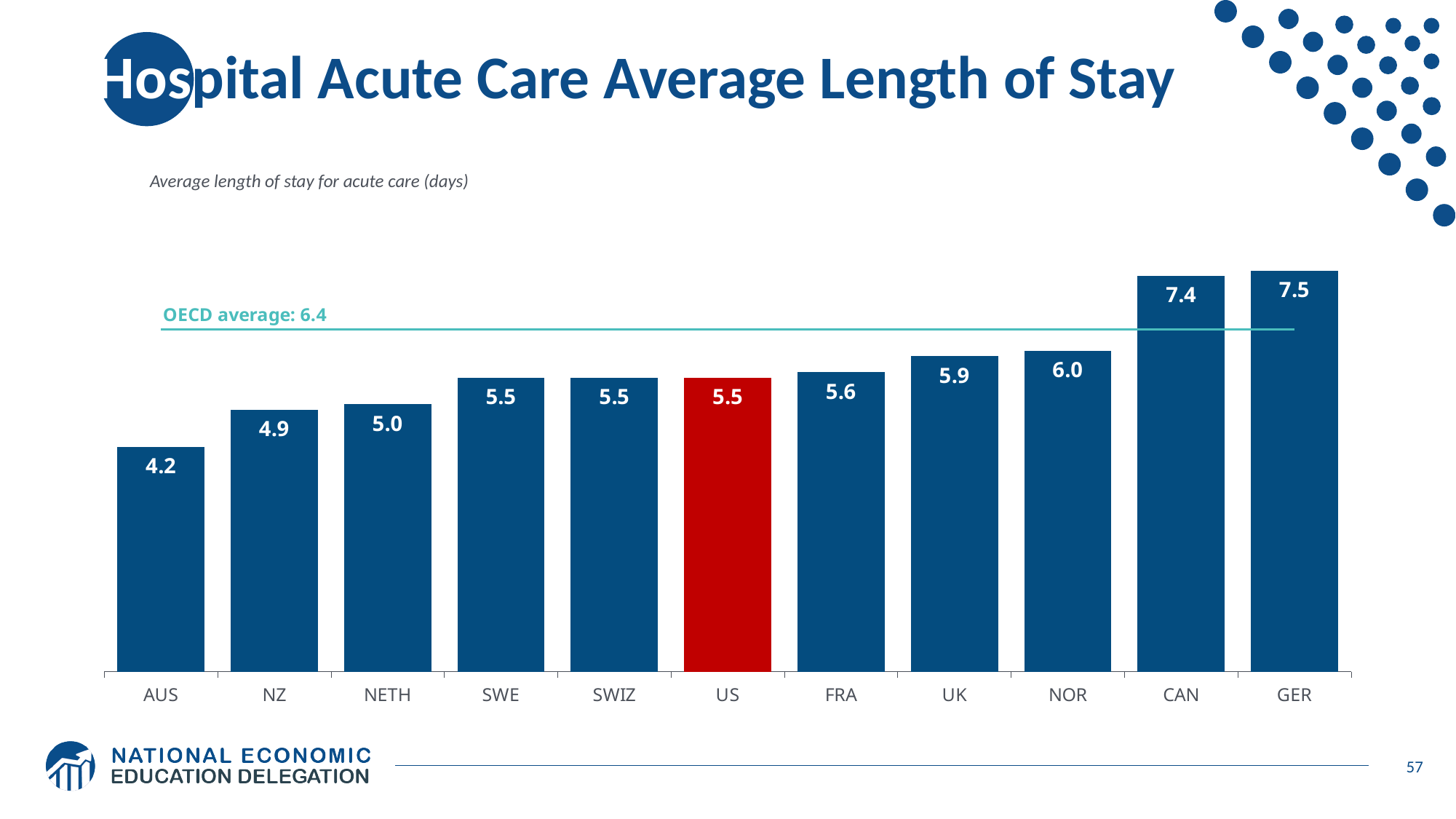
What is the average length of stay for acute care in the US? 5.5 What is the difference between the values for CAN and US? 1.9 What is the difference between the values for GER and AUS? 3.3 How many countries are shown on the chart? 11 Which has a longer average length of stay, UK or NZ? UK Do the values generally rise or fall from left to right along the x axis? Rise What OECD average value is marked by the horizontal line on the chart? 6.4 What kind of chart is shown on the slide? Bar chart Which country has the lowest average length of stay for acute care? AUS Which country has the highest average length of stay for acute care? GER What is the average length of stay for acute care in Germany (GER)? 7.5 What is the value shown for NOR? 6.0